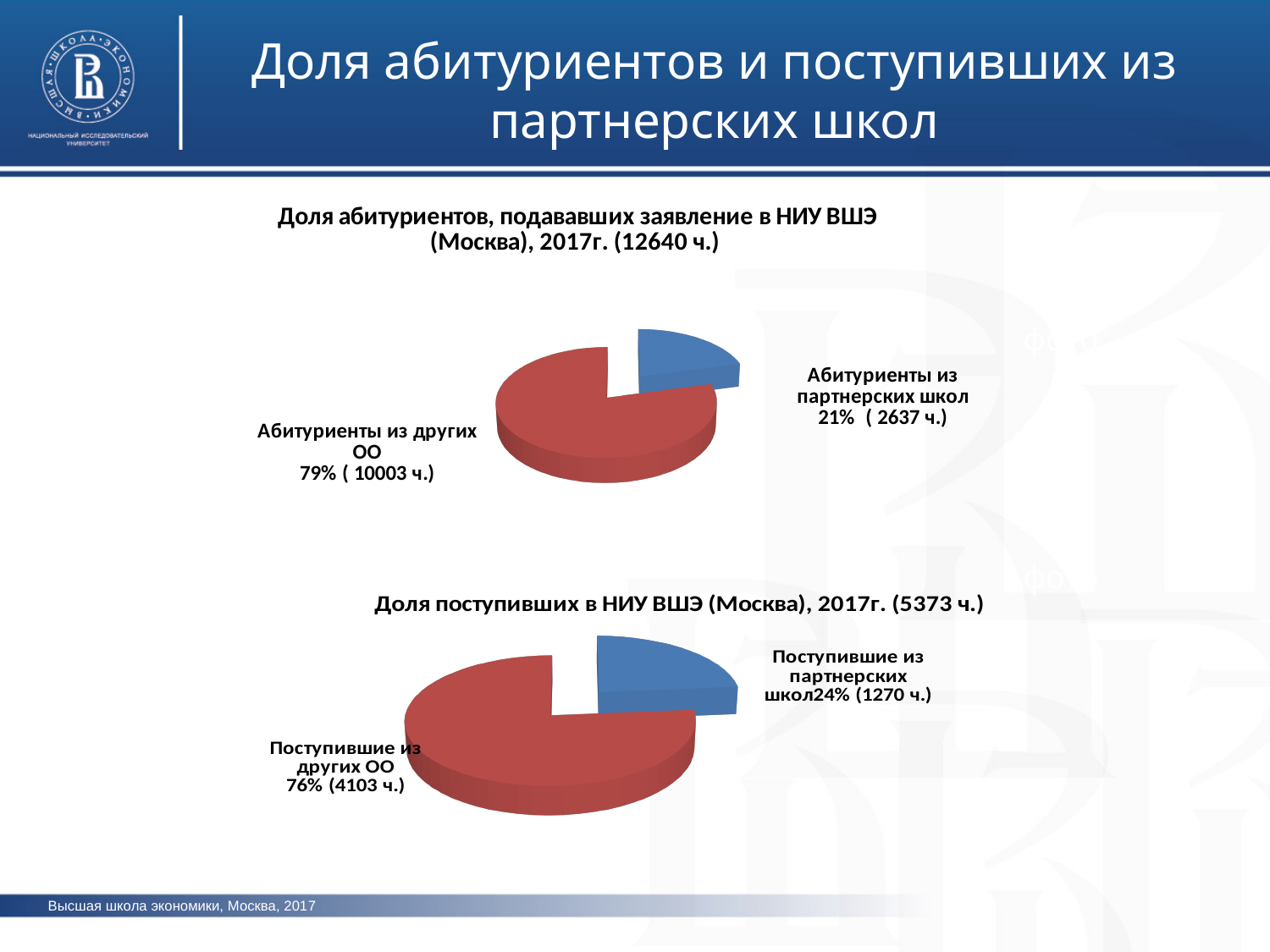
In the bottom chart (Доля поступивших в НИУ ВШЭ), which slice is the smallest? Поступившие из партнерских школ What total number of admitted students is given in the title of the bottom chart (Доля поступивших в НИУ ВШЭ)? 5373 ч. In the top chart (Доля абитуриентов, подававших заявление в НИУ ВШЭ), how many applicants came from partner schools? 2637 ч. How many slices does the bottom chart (Доля поступивших в НИУ ВШЭ) have? 2 In the top chart (Доля абитуриентов, подававших заявление в НИУ ВШЭ), what share of applicants came from partner schools (Абитуриенты из партнерских школ)? 21% In the top chart (Доля абитуриентов, подававших заявление в НИУ ВШЭ), how many applicants came from other educational organisations (Абитуриенты из других ОО)? 10003 ч. In the bottom chart (Доля поступивших в НИУ ВШЭ), how many admitted students came from partner schools? 1270 ч. What type of chart is used in the top chart (Доля абитуриентов, подававших заявление в НИУ ВШЭ)? Pie chart In the bottom chart (Доля поступивших в НИУ ВШЭ), how many admitted students came from other educational organisations (Поступившие из других ОО)? 4103 ч. In the top chart (Доля абитуриентов, подававших заявление в НИУ ВШЭ), what is the difference in number of people between applicants from other ОО and applicants from partner schools? 7366 ч. In the top chart (Доля абитуриентов, подававших заявление в НИУ ВШЭ), which slice is the largest? Абитуриенты из других ОО In the bottom chart (Доля поступивших в НИУ ВШЭ), what share of admitted students came from partner schools (Поступившие из партнерских школ)? 24%